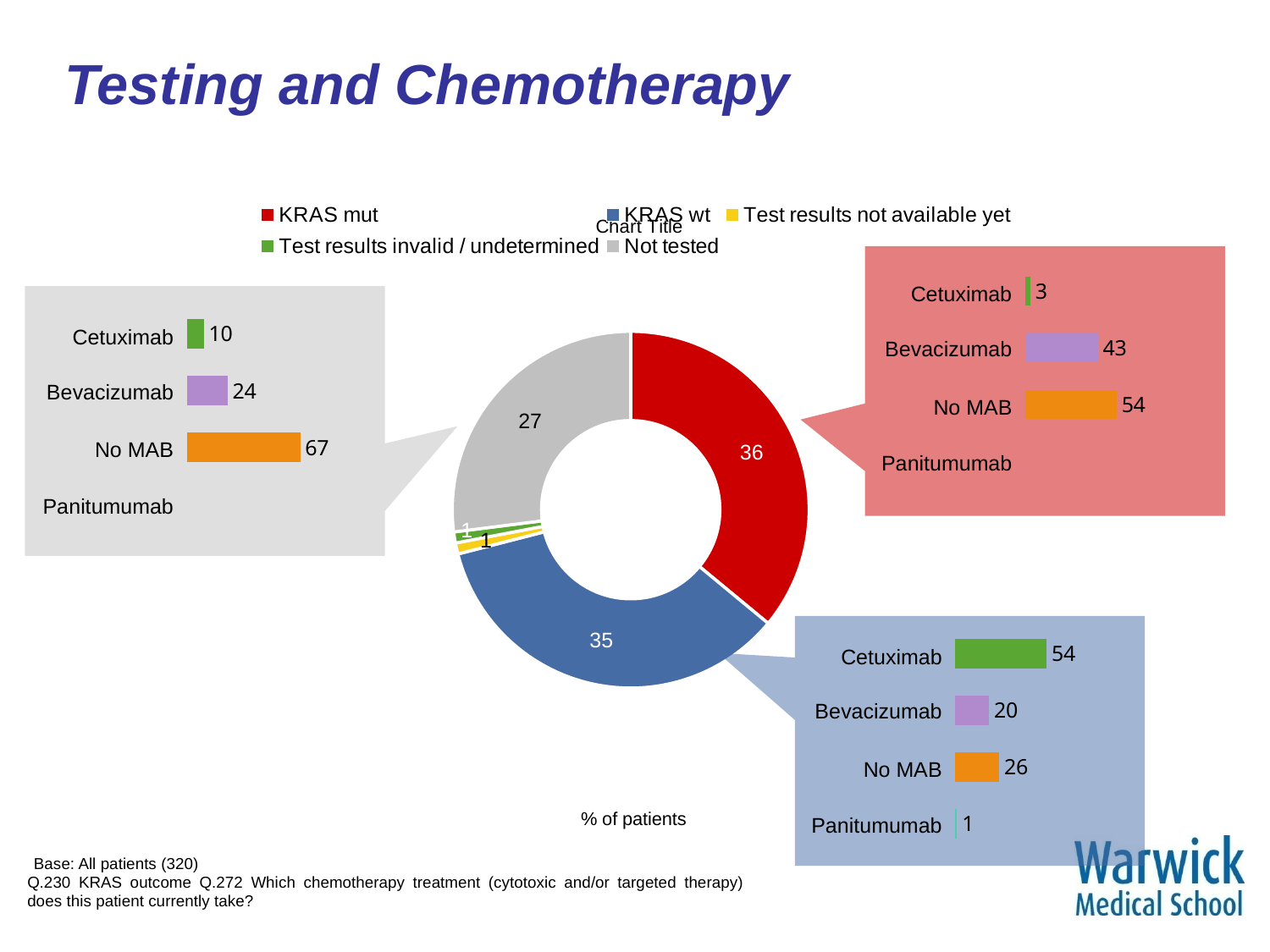
How many entries does the legend of the donut chart list? 5 In the donut chart in the centre of the slide, which category has the largest share? KRAS mut In the bar chart in the blue box at the bottom right of the slide, how many categories are shown? 4 In the bar chart in the blue box at the bottom right of the slide, what is the value for Cetuximab? 54 In the bar chart in the red box at the top right of the slide, what is the value for Bevacizumab? 43 In the donut chart in the centre of the slide, what percentage of patients are KRAS mut? 36 In the bar chart in the grey box on the left of the slide, which category has the lowest labelled value? Cetuximab In the bar chart in the blue box at the bottom right of the slide, which is larger, Bevacizumab or No MAB? No MAB In the bar chart in the grey box on the left of the slide, what is the value for No MAB? 67 In the donut chart in the centre of the slide, what percentage of patients are Not tested? 27 What kind of chart is the chart in the centre of the slide? Donut chart In the bar chart in the red box at the top right of the slide, what is the difference between No MAB and Cetuximab? 51